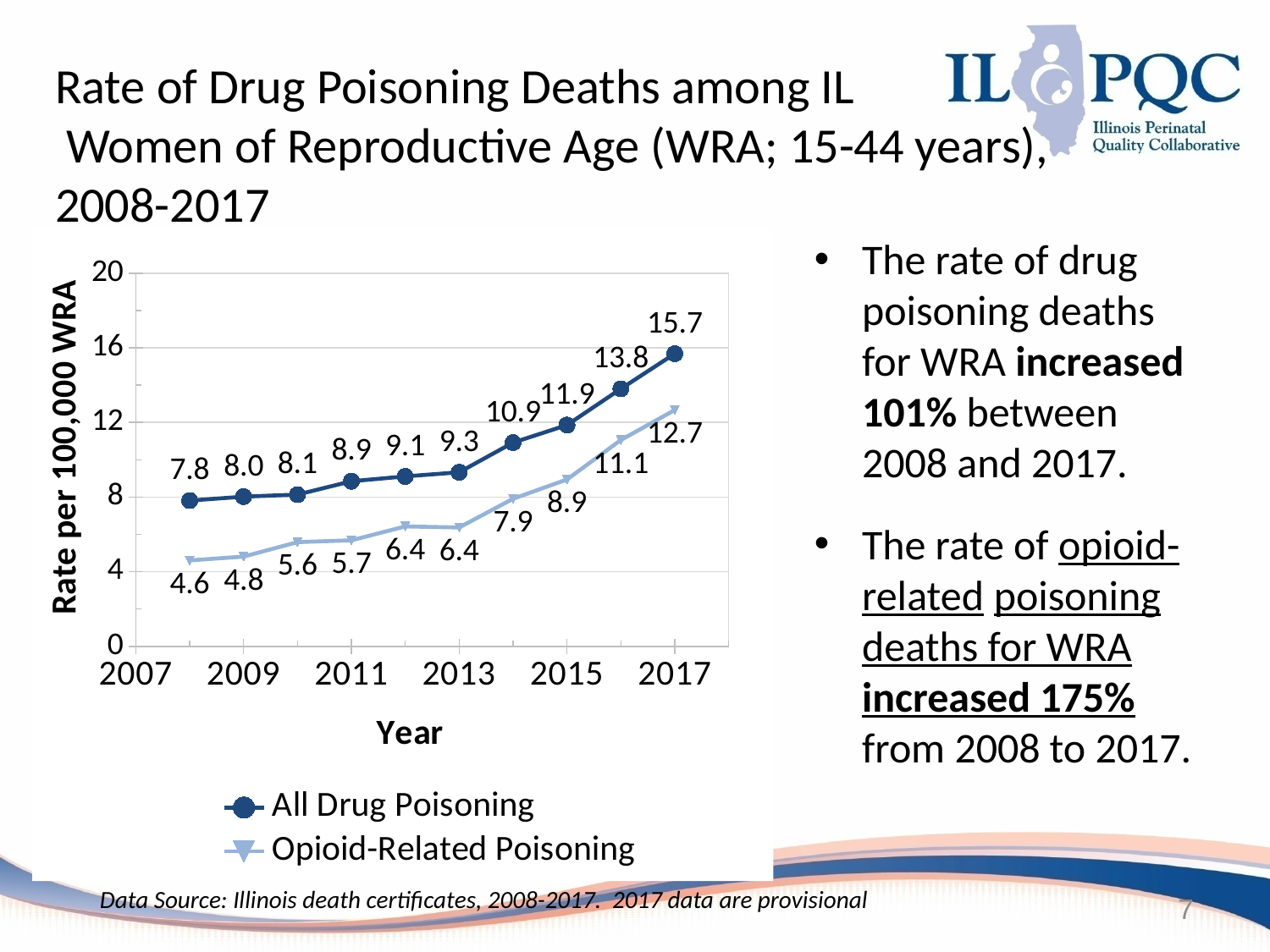
What was the All Drug Poisoning rate in 2017? 15.7 In which year was the All Drug Poisoning rate highest? 2017 What is the label of the y axis? Rate per 100,000 WRA What was the Opioid-Related Poisoning rate in 2008? 4.6 How many series does the legend list? 2 Which series had the higher rate in 2015, All Drug Poisoning or Opioid-Related Poisoning? All Drug Poisoning What was the Opioid-Related Poisoning rate in 2016? 11.1 What is the difference between the All Drug Poisoning rate and the Opioid-Related Poisoning rate in 2017? 3.0 What type of chart is shown on the slide? Line chart What was the All Drug Poisoning rate in 2014? 10.9 Does the Opioid-Related Poisoning rate rise or fall from 2008 to 2017? Rise In which year was the Opioid-Related Poisoning rate lowest? 2008